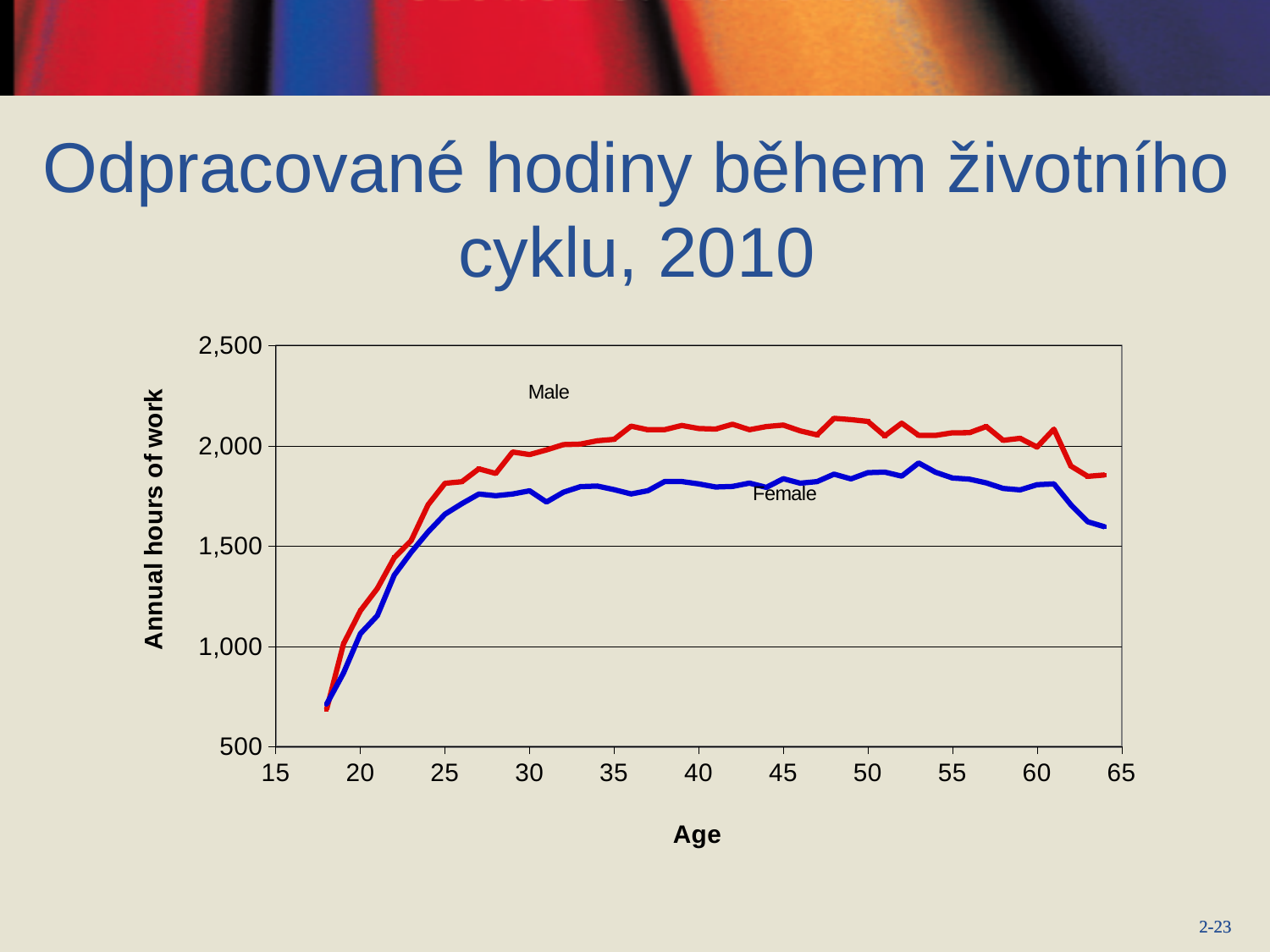
How many series are plotted on the chart? 2 Which series has the higher annual hours of work at age 45, Male or Female? Male Is the value for Female at age 18 greater or less than 1,000? less Do the annual hours of work for Male rise or fall between age 18 and age 25? rise Is the value for Female at age 64 greater or less than 2,000? less What kind of chart is shown on the slide? line chart Which series has the higher annual hours of work at age 30, Male or Female? Male Is the value for Male at age 25 greater or less than 1,500? greater What is the title of the vertical axis of the chart? Annual hours of work Do the annual hours of work for Female rise or fall between age 61 and age 64? fall